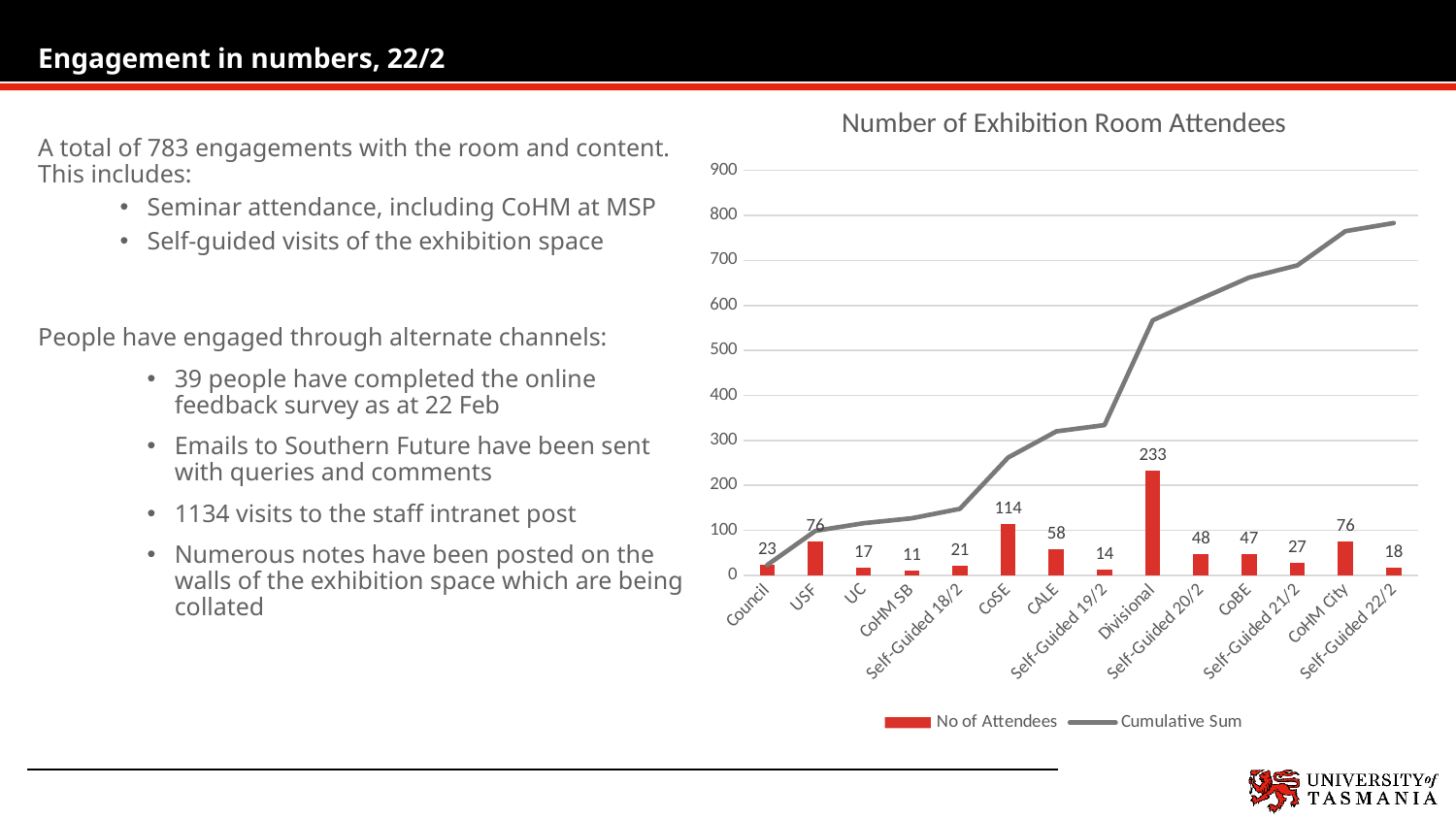
Which category has the highest number of attendees? Divisional Does the Cumulative Sum line rise or fall along the x axis? Rises What type of chart is used to show the No of Attendees series? Bar chart What is the number of attendees for CoSE? 114 How many categories are shown on the x axis? 14 What is the title of the chart? Number of Exhibition Room Attendees What is the number of attendees for Divisional? 233 Which category has the lowest number of attendees? CoHM SB What is the difference in attendees between Divisional and CoSE? 119 Is the Cumulative Sum value at Self-Guided 22/2 greater or less than 700? greater How many series does the legend list? 2 Which has more attendees, CALE or CoBE? CALE